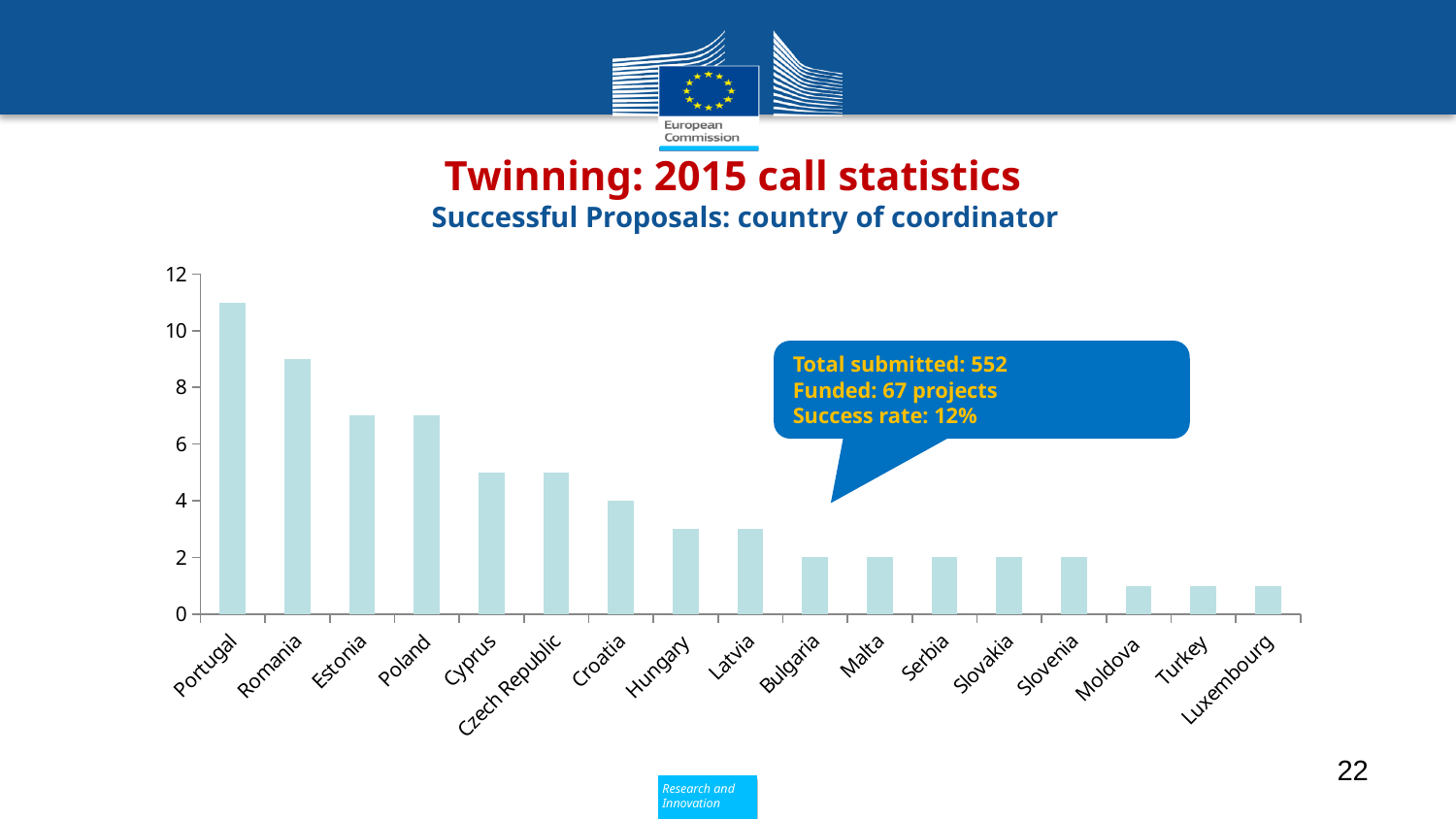
Which has a larger value, Portugal or Romania? Portugal Is the value for Portugal greater or less than 10? greater Is the value for Cyprus greater or less than 6? less Is the value for Romania greater or less than 8? greater What is the value for Bulgaria? 2 What is the value for Slovenia? 2 Which country has the highest number of successful proposals? Portugal What kind of chart is shown on the slide? bar chart How many countries are shown on the x axis? 17 What is the value for Croatia? 4 Do the values rise or fall from left to right along the x axis? fall